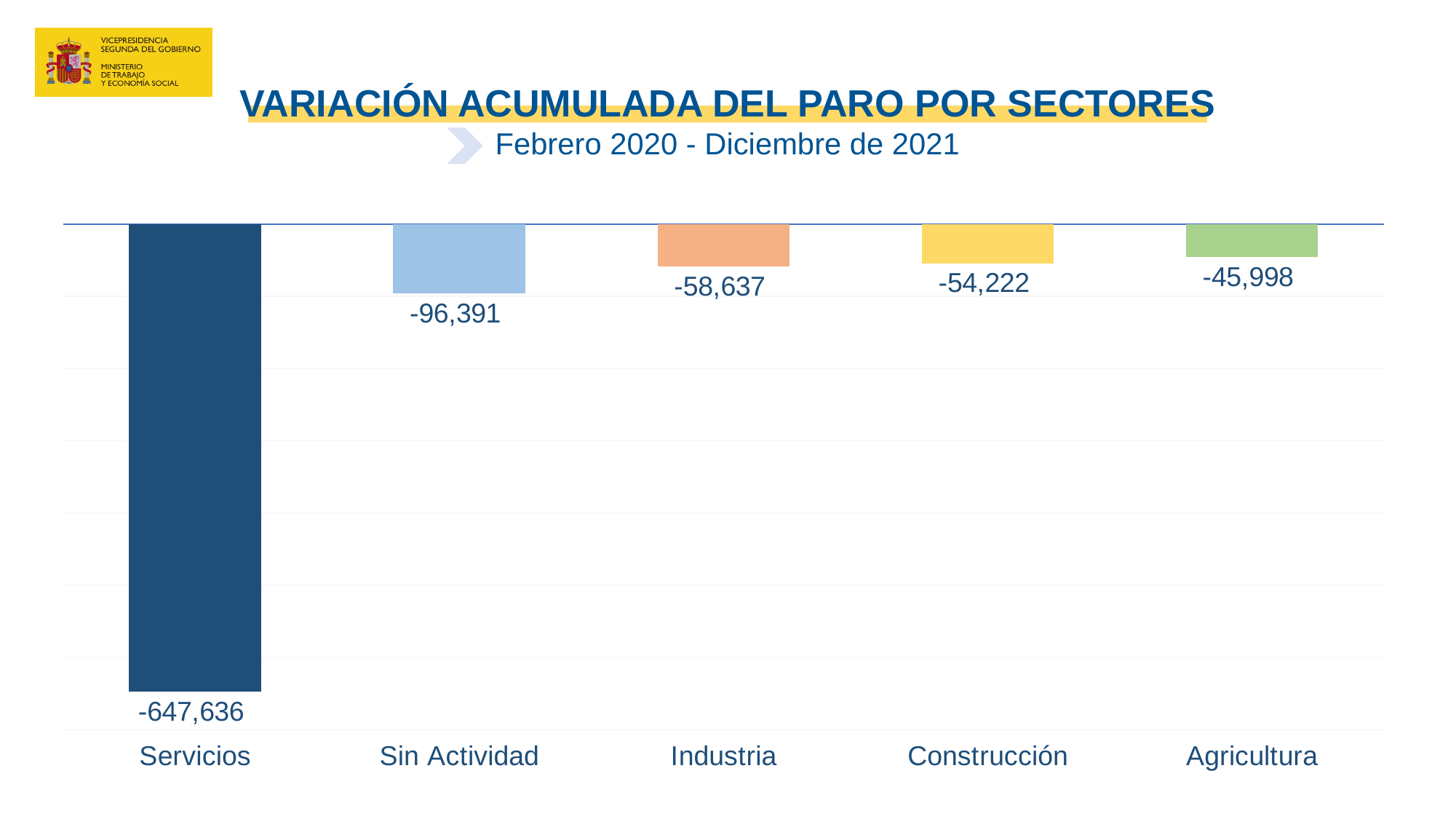
Which sector has the larger decrease, Industria or Construcción? Industria What is the value shown for Construcción? -54,222 How many sectors are shown in the chart? 5 What is the difference between the values for Construcción and Agricultura? 8,224 Which sector shows the largest decrease (the most negative value)? Servicios What is the value shown for Servicios? -647,636 What is the value shown for Sin Actividad? -96,391 By how much does the decrease for Sin Actividad exceed the decrease for Industria? 37,754 What is the value shown for Industria? -58,637 What is the value shown for Agricultura? -45,998 Which sector shows the smallest decrease (the value closest to zero)? Agricultura What kind of chart is shown on the slide? Bar chart